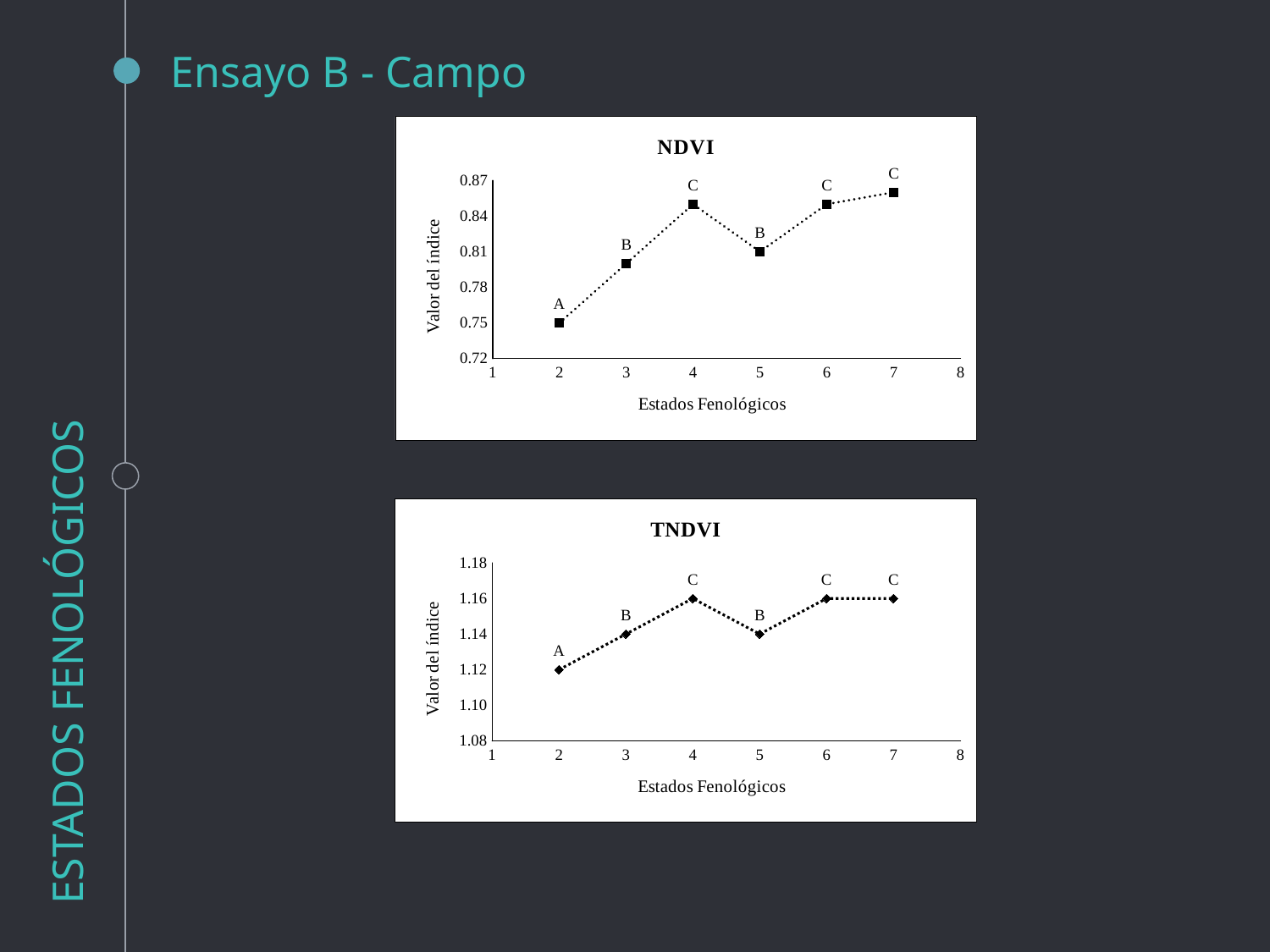
In the NDVI chart, what is the value at estado fenológico 2? 0.75 How many data points are plotted in the NDVI chart? 6 In the NDVI chart, is the value at estado fenológico 3 greater or less than 0.81? less In the NDVI chart, which estado fenológico has the lowest value? 2 In the NDVI chart, is the value at estado fenológico 4 greater or less than 0.84? greater In the NDVI chart, what is the value at estado fenológico 5? 0.81 In the TNDVI chart, what is the value at estado fenológico 4? 1.16 In the TNDVI chart, which is larger, the value at estado fenológico 3 or at estado fenológico 4? estado fenológico 4 In the TNDVI chart, what is the value at estado fenológico 2? 1.12 In the TNDVI chart, which estado fenológico has the lowest value? 2 What is the y-axis label of the TNDVI chart? Valor del índice What kind of chart is the NDVI chart? line chart